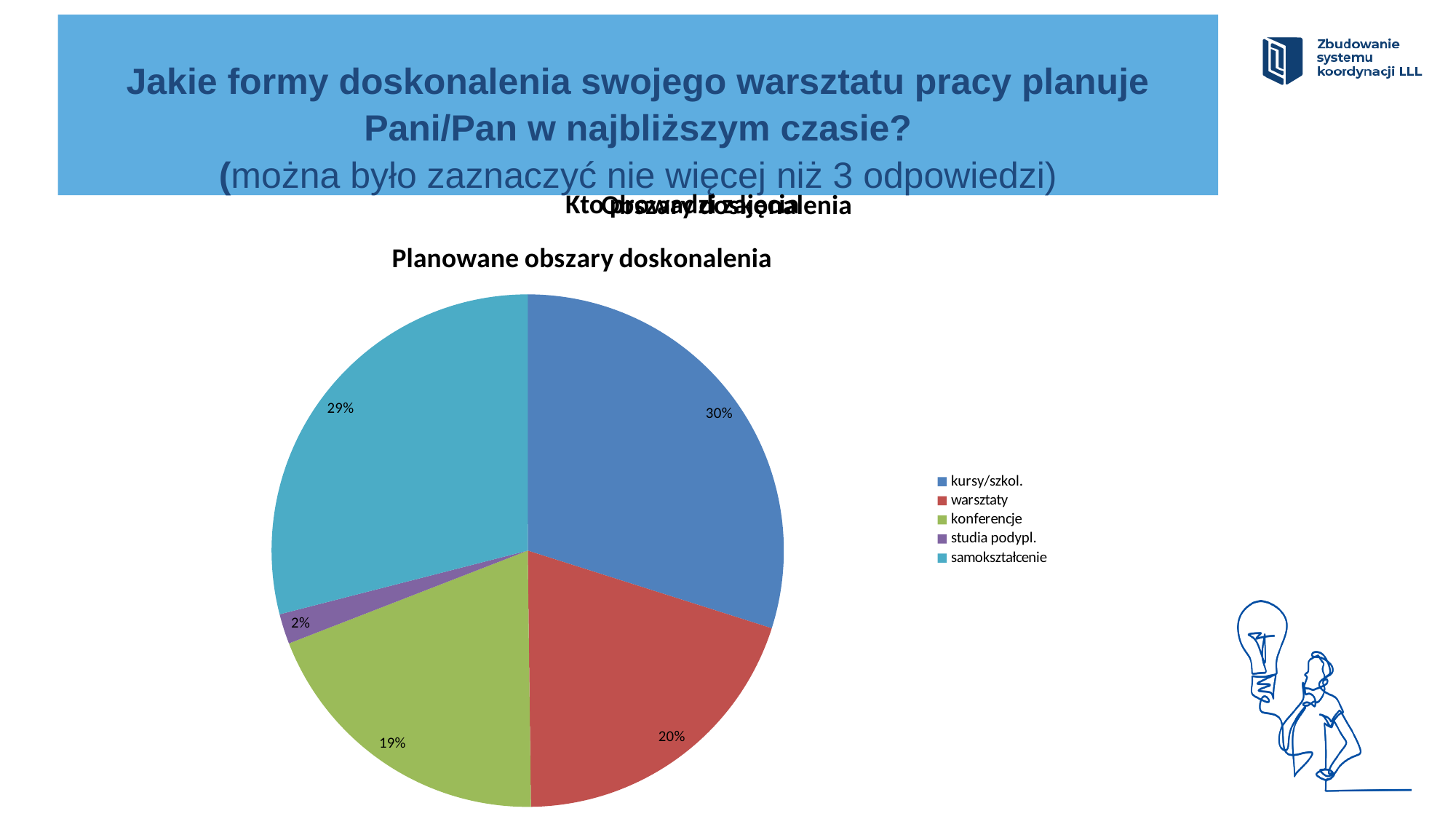
Which category has the largest slice of the pie? kursy/szkol. What share of the pie does warsztaty have? 20% What share of the pie does samokształcenie have? 29% What share of the pie does studia podypl. have? 2% What is the title of the pie chart? Planowane obszary doskonalenia How many categories does the legend list? 5 What type of chart is shown on the slide? pie chart What is the difference in percentage points between kursy/szkol. and konferencje? 11 What share of the pie does kursy/szkol. have? 30% What share of the pie does konferencje have? 19% Which category has the smallest slice of the pie? studia podypl. Which is larger, the share for warsztaty or the share for konferencje? warsztaty